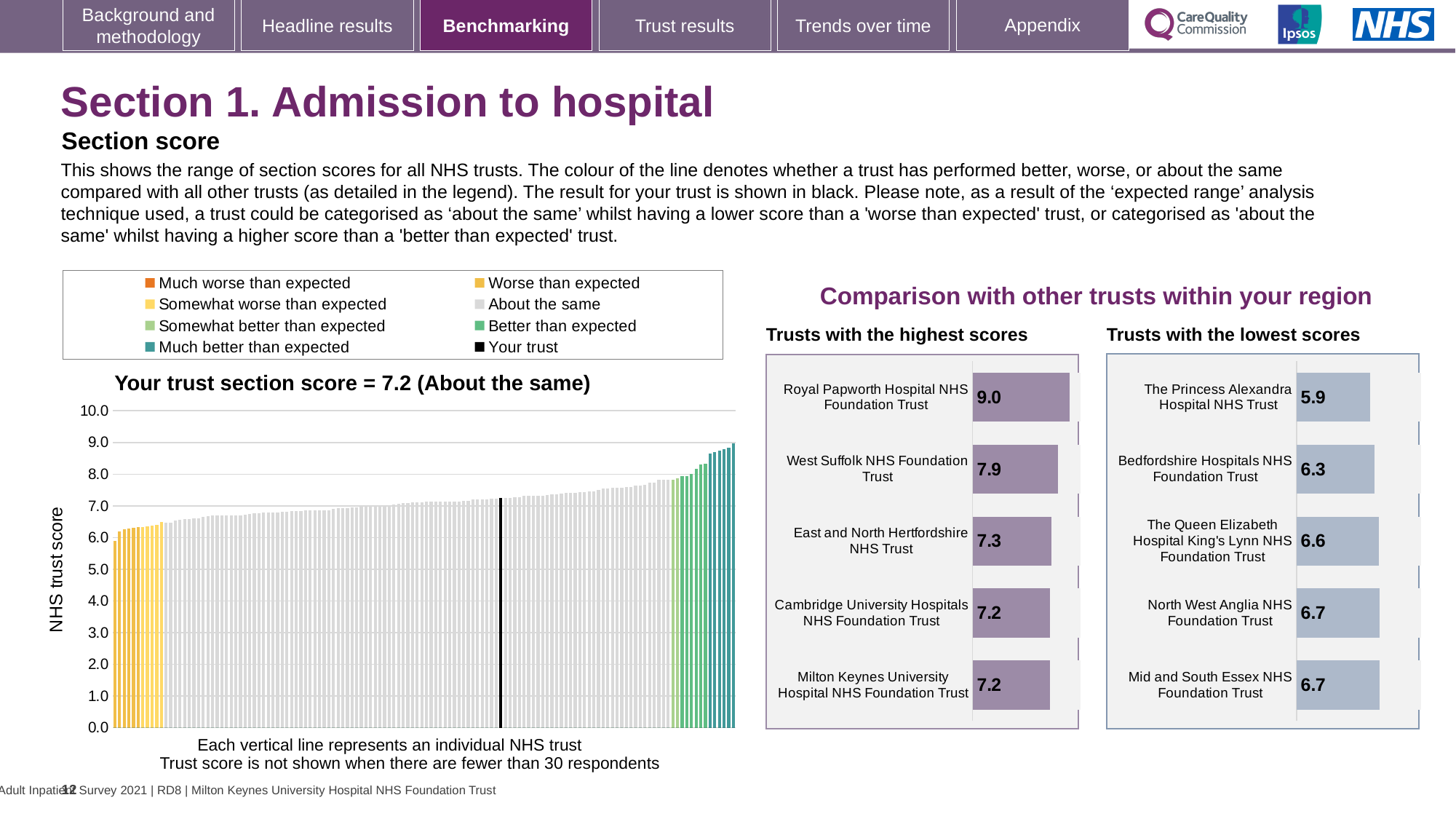
In the 'Trusts with the highest scores' chart, what is the score for Royal Papworth Hospital NHS Foundation Trust? 9.0 In the 'Trusts with the lowest scores' chart, what is the difference between the scores of North West Anglia NHS Foundation Trust and The Princess Alexandra Hospital NHS Trust? 0.8 In the 'Trusts with the lowest scores' chart, which trust has the lowest score? The Princess Alexandra Hospital NHS Trust In the 'Trusts with the lowest scores' chart, what is the score for The Princess Alexandra Hospital NHS Trust? 5.9 In the 'Your trust section score' chart on the left, do the bar values rise or fall from left to right along the x axis? Rise In the 'Trusts with the highest scores' chart, what is the score for West Suffolk NHS Foundation Trust? 7.9 In the 'Trusts with the highest scores' chart, which trust has the highest score? Royal Papworth Hospital NHS Foundation Trust In the 'Trusts with the lowest scores' chart, what is the score for Bedfordshire Hospitals NHS Foundation Trust? 6.3 In the 'Trusts with the highest scores' chart, which has the larger score: East and North Hertfordshire NHS Trust or Cambridge University Hospitals NHS Foundation Trust? East and North Hertfordshire NHS Trust How many trusts are shown in the 'Trusts with the lowest scores' chart? 5 What type of chart is the 'Your trust section score' chart on the left of the slide? Bar chart In the 'Trusts with the highest scores' chart, what is the difference between the scores of Royal Papworth Hospital NHS Foundation Trust and West Suffolk NHS Foundation Trust? 1.1